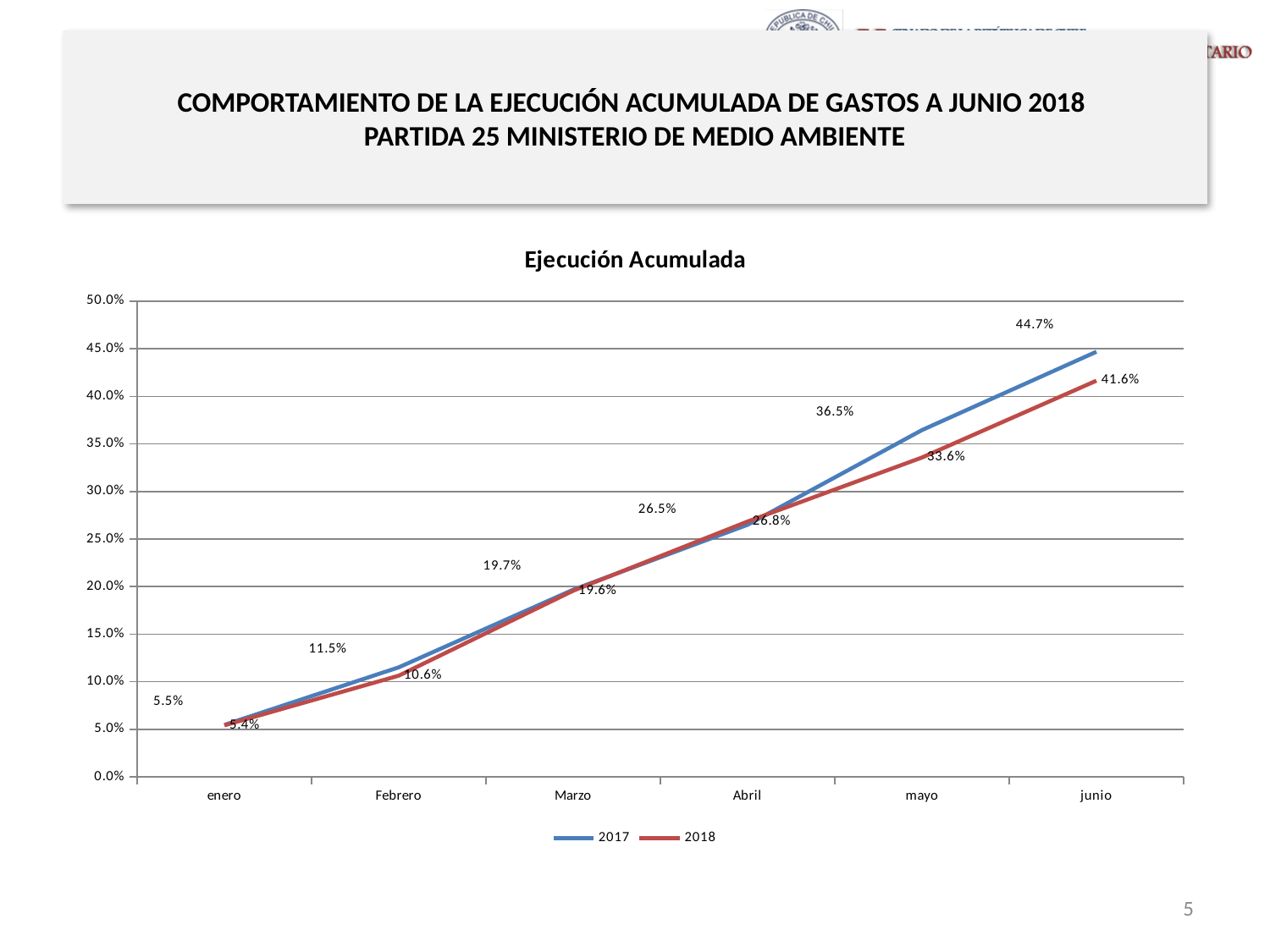
Which series has the higher value in Abril, 2017 or 2018? 2018 What is the title of the chart? Ejecución Acumulada Do the values for 2018 rise or fall from enero to junio? rise How many months are shown on the x axis? 6 What is the value for 2018 in mayo? 33.6% How many series does the legend list? 2 In which month is the 2017 series lowest? enero What type of chart is shown on the slide? line chart Which colour is used for the 2018 series? red What is the value for 2018 in Febrero? 10.6% What is the difference between the 2017 and 2018 values in junio? 3.1% What is the value for 2017 in junio? 44.7%